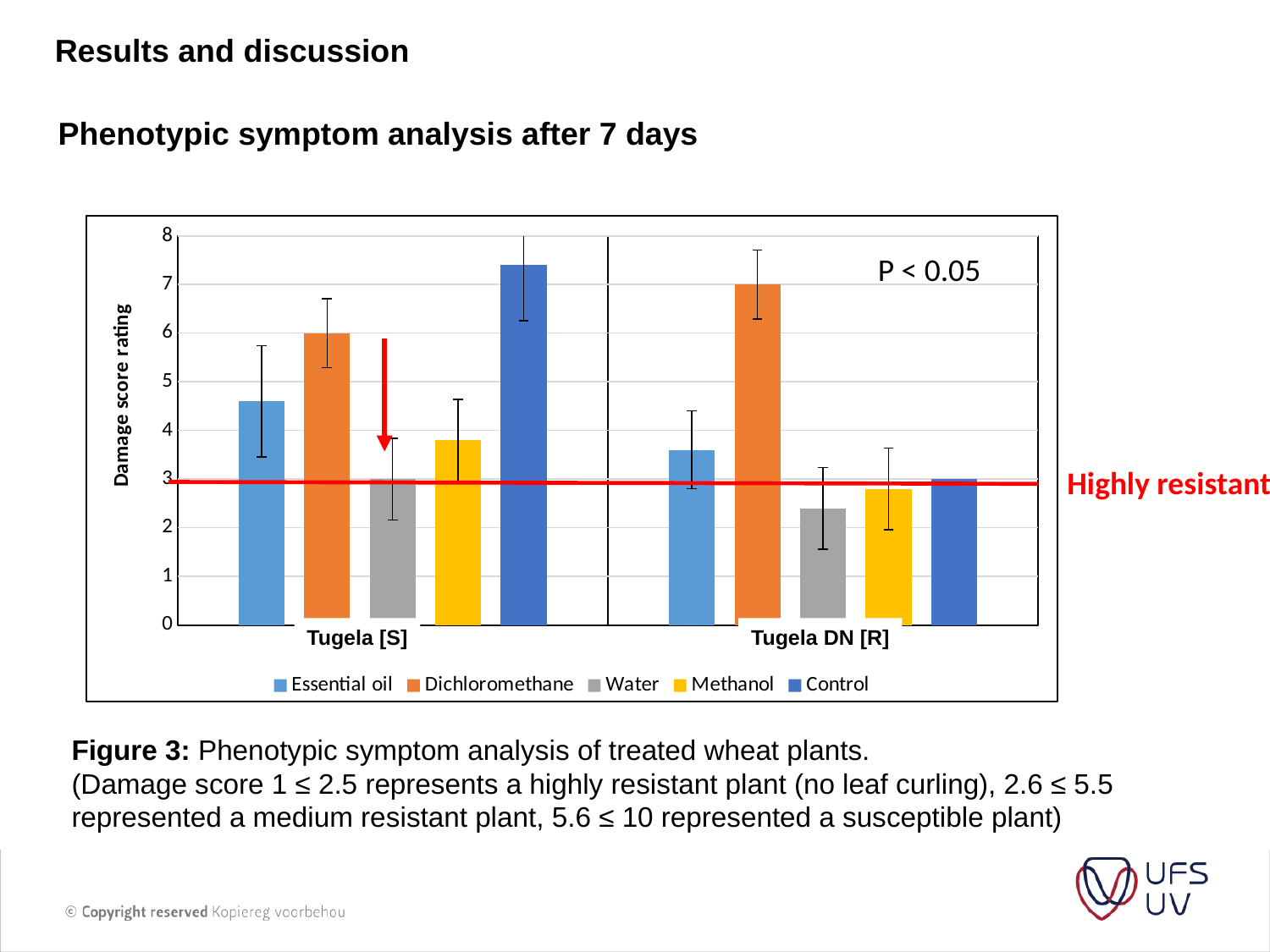
Which cultivar has the larger damage score rating for Dichloromethane, Tugela [S] or Tugela DN [R]? Tugela DN [R] Is the damage score rating for Water in Tugela DN [R] greater or less than 3? less How many wheat cultivar categories are shown on the x axis? 2 Which treatment has the lowest damage score rating for Tugela DN [R]? Water Is the damage score rating for Control in Tugela [S] greater or less than 7? greater Which treatment has the lowest damage score rating for Tugela [S]? Water Is the damage score rating for Essential oil in Tugela [S] greater or less than 4? greater Which treatment has the highest damage score rating for Tugela [S]? Control What kind of chart is shown on the slide? Bar chart How many series does the legend list? 5 What is the label of the y axis? Damage score rating Which treatment has the highest damage score rating for Tugela DN [R]? Dichloromethane